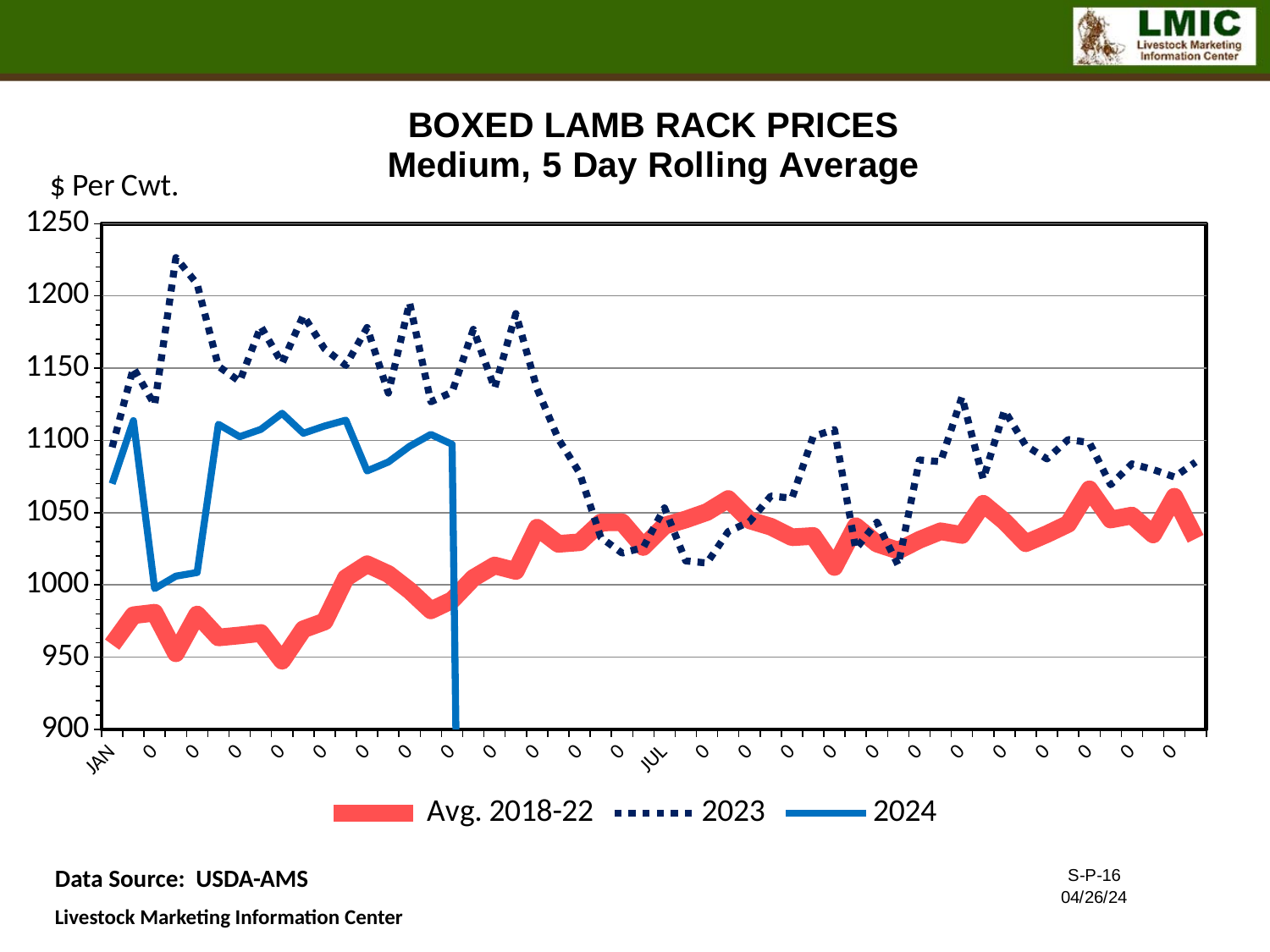
What unit is shown on the y axis? $ Per Cwt. Which series reaches the highest value on the chart? 2023 What is the title of the chart? BOXED LAMB RACK PRICES Medium, 5 Day Rolling Average Is the value of the Avg. 2018-22 series at JAN greater or less than 1000? less At JAN, which is higher: the 2023 series or the Avg. 2018-22 series? 2023 Does the 2023 series generally rise or fall from its early-year peak to JUL? fall Is the value of the 2024 series at JAN greater or less than 1050? greater What kind of chart is shown on the slide? line chart Is the peak value of the 2023 series greater or less than 1200? greater How many series does the legend list? 3 Does the Avg. 2018-22 series generally rise or fall from JAN to JUL? rise